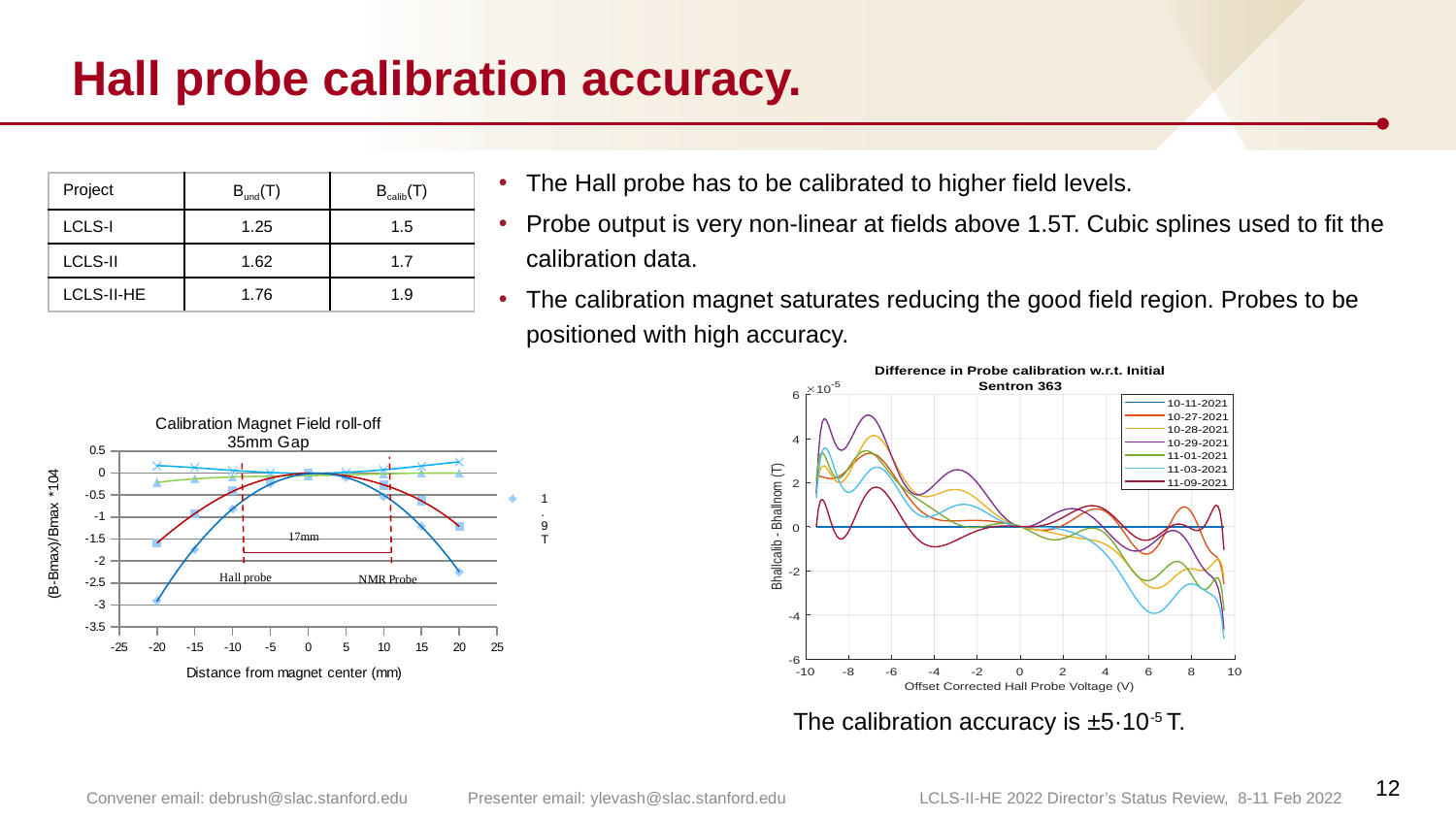
On the 'Calibration Magnet Field roll-off 35mm Gap' chart, how does the blue series change as the distance goes from -20 mm to 0 mm? it rises On the 'Calibration Magnet Field roll-off 35mm Gap' chart, is the value of the green series at -20 mm greater or less than -0.5? greater What is the lowest tick shown on the x axis of the 'Calibration Magnet Field roll-off 35mm Gap' chart? -25 On the 'Calibration Magnet Field roll-off 35mm Gap' chart, is the value of the blue series at 20 mm greater or less than -2? less On the 'Calibration Magnet Field roll-off 35mm Gap' chart, is the value of the blue series at -20 mm greater or less than -2.5? less What kind of chart is the 'Difference in Probe calibration w.r.t. Initial Sentron 363' chart on the right? line chart How many series does the legend of the 'Difference in Probe calibration w.r.t. Initial Sentron 363' chart list? 7 What is the title of the chart on the right of the slide? Difference in Probe calibration w.r.t. Initial Sentron 363 How many series are plotted on the 'Calibration Magnet Field roll-off 35mm Gap' chart? 4 What kind of chart is the 'Calibration Magnet Field roll-off 35mm Gap' chart on the left? line chart On the 'Calibration Magnet Field roll-off 35mm Gap' chart, what width is annotated between the two dashed lines? 17mm On the 'Calibration Magnet Field roll-off 35mm Gap' chart, which series reaches the lowest value at -20 mm? the blue series